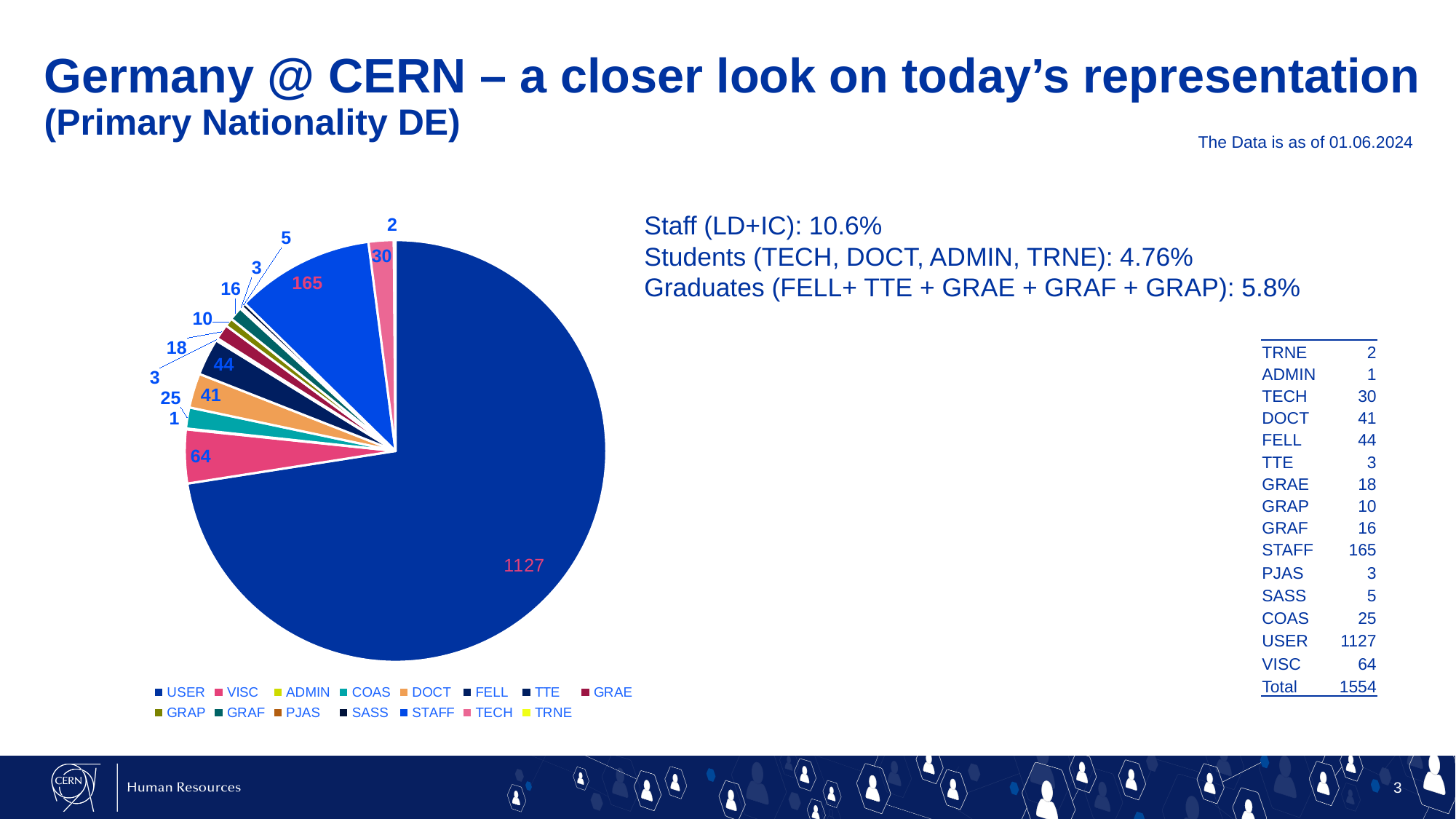
What is the value for VISC in the pie chart? 64 Which category has the largest slice in the pie chart? USER Which is larger, the value for FELL or the value for DOCT? FELL How many categories does the pie chart legend list? 15 What is the difference between the values for STAFF and VISC? 101 What is the total of all categories shown in the table next to the pie chart? 1554 What kind of chart is shown on the slide? pie chart What is the value for USER in the pie chart? 1127 What is the value for TECH in the pie chart? 30 What is the value for STAFF in the pie chart? 165 What is the title of the slide containing the pie chart? Germany @ CERN – a closer look on today's representation (Primary Nationality DE) Which category has the smallest value in the pie chart? ADMIN